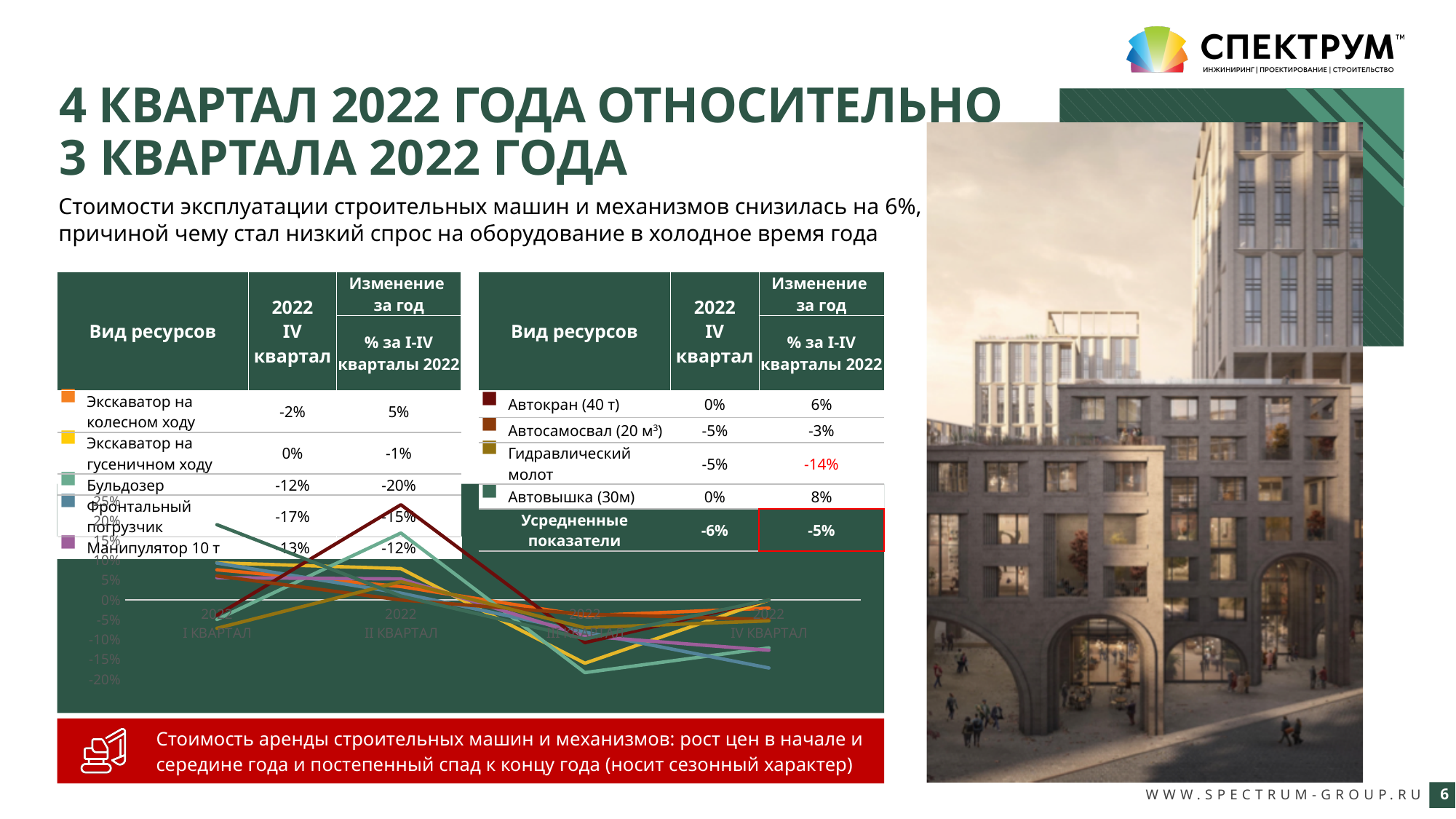
In the line chart, is the value of the light green line (Бульдозер) at 2022 III квартал greater or less than -10%? less What is the label of the last point on the x axis of the line chart? 2022 IV КВАРТАЛ In the line chart, is the value of the dark red line (Автокран) at 2022 I квартал greater or less than 0%? less In the line chart, at which quarter does the dark red line (Автокран) reach its highest value? 2022 II квартал In the line chart, do the lines generally rise or fall from 2022 II квартал to 2022 III квартал? fall What kind of chart is shown on the slide? line chart What is the highest value shown on the y axis of the line chart? 25% In the line chart, is the value of the dark red line (Автокран) at 2022 II квартал greater or less than 10%? greater How many quarters are plotted along the x axis of the line chart? 4